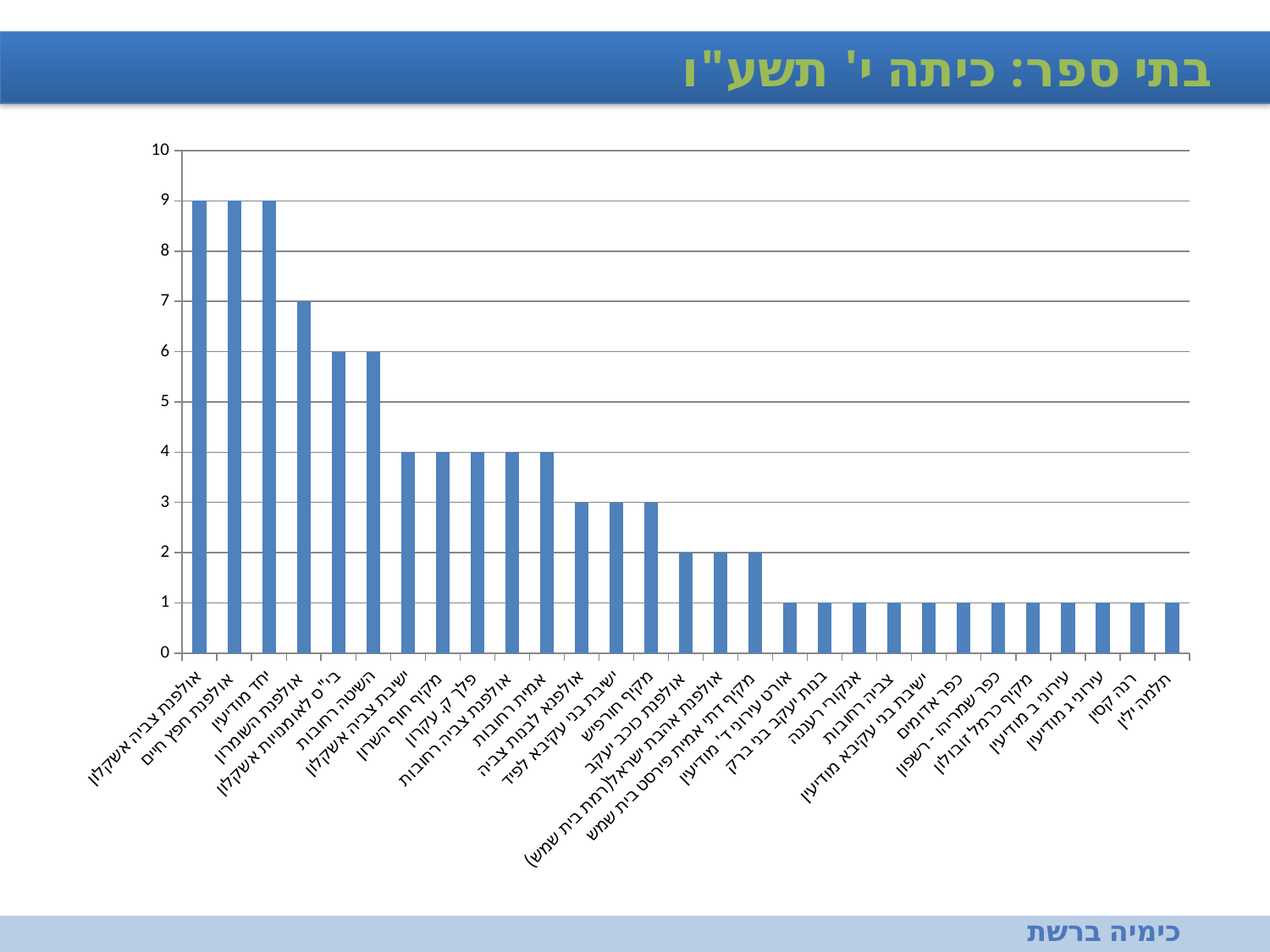
What is the lowest value shown in the chart? 1 What is the highest value shown in the chart? 9 What is the value for מקיף חורפיש? 3 Which has a larger value, יחד מודיעין or אמית רחובות? יחד מודיעין What kind of chart is shown on the slide? bar chart How many bars (categories) are shown in the chart? 29 What is the value for השיטה רחובות? 6 What is the difference between the values for אולפנת השומרון and מקיף חורפיש? 4 What is the value for אולפנת כוכב יעקב? 2 What is the value for תלמה ילין? 1 Do the values rise or fall moving from left to right along the x axis? fall What is the value for אולפנת השומרון? 7